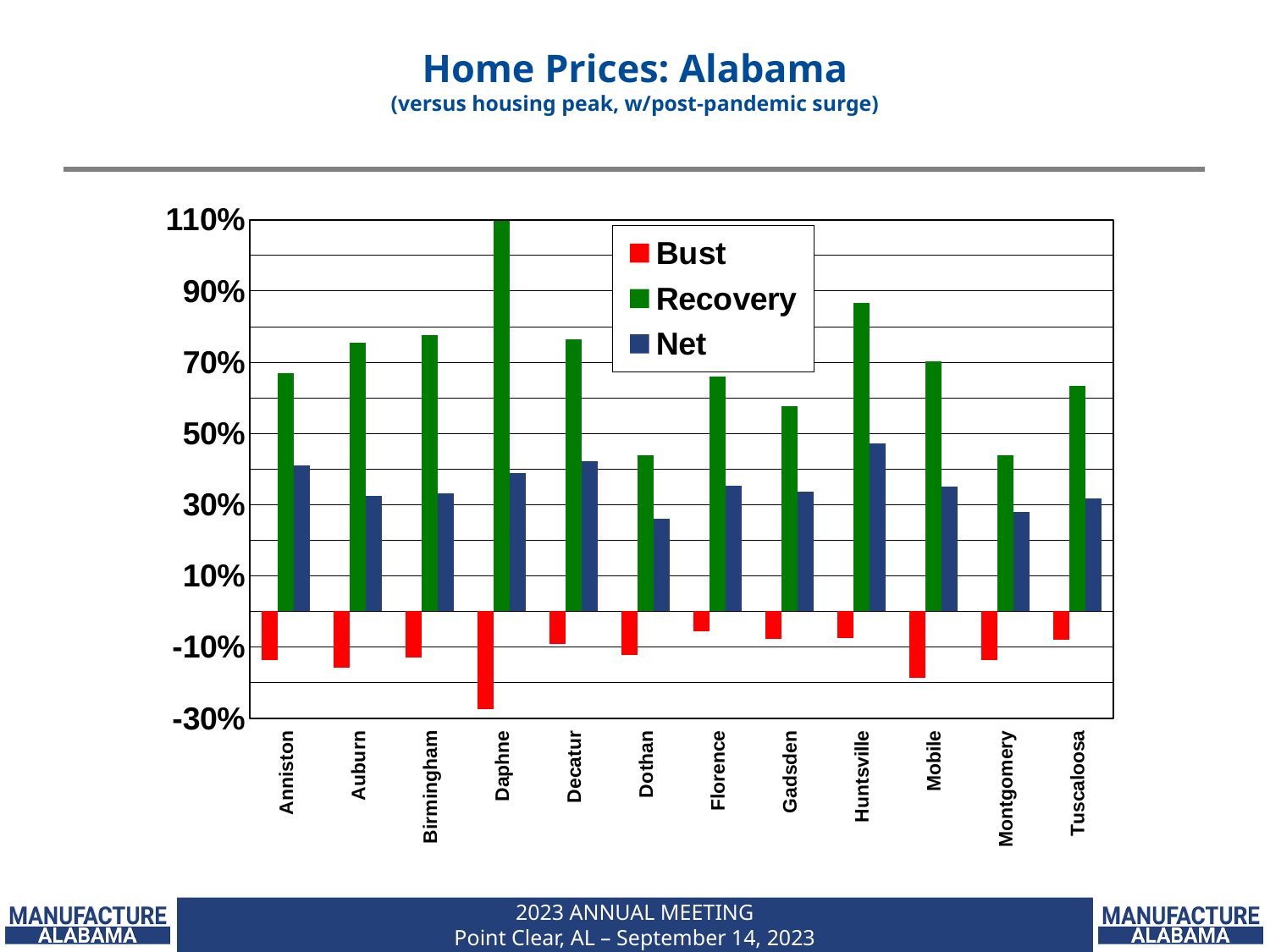
Is the Net value for Dothan greater or less than 30%? less Which city has the lowest (most negative) Bust value? Daphne What is the title of the chart? Home Prices: Alabama Which city has the larger Recovery value, Auburn or Dothan? Auburn Is the Recovery value for Huntsville greater or less than 70%? greater How many series does the legend list? 3 Is the Bust value for Daphne greater or less than -10%? less Which city has the highest Net value? Huntsville Which city has the highest Recovery value? Daphne How many cities are shown on the x axis? 12 What colour represents the Net series in the legend? blue What kind of chart is shown on the slide? bar chart